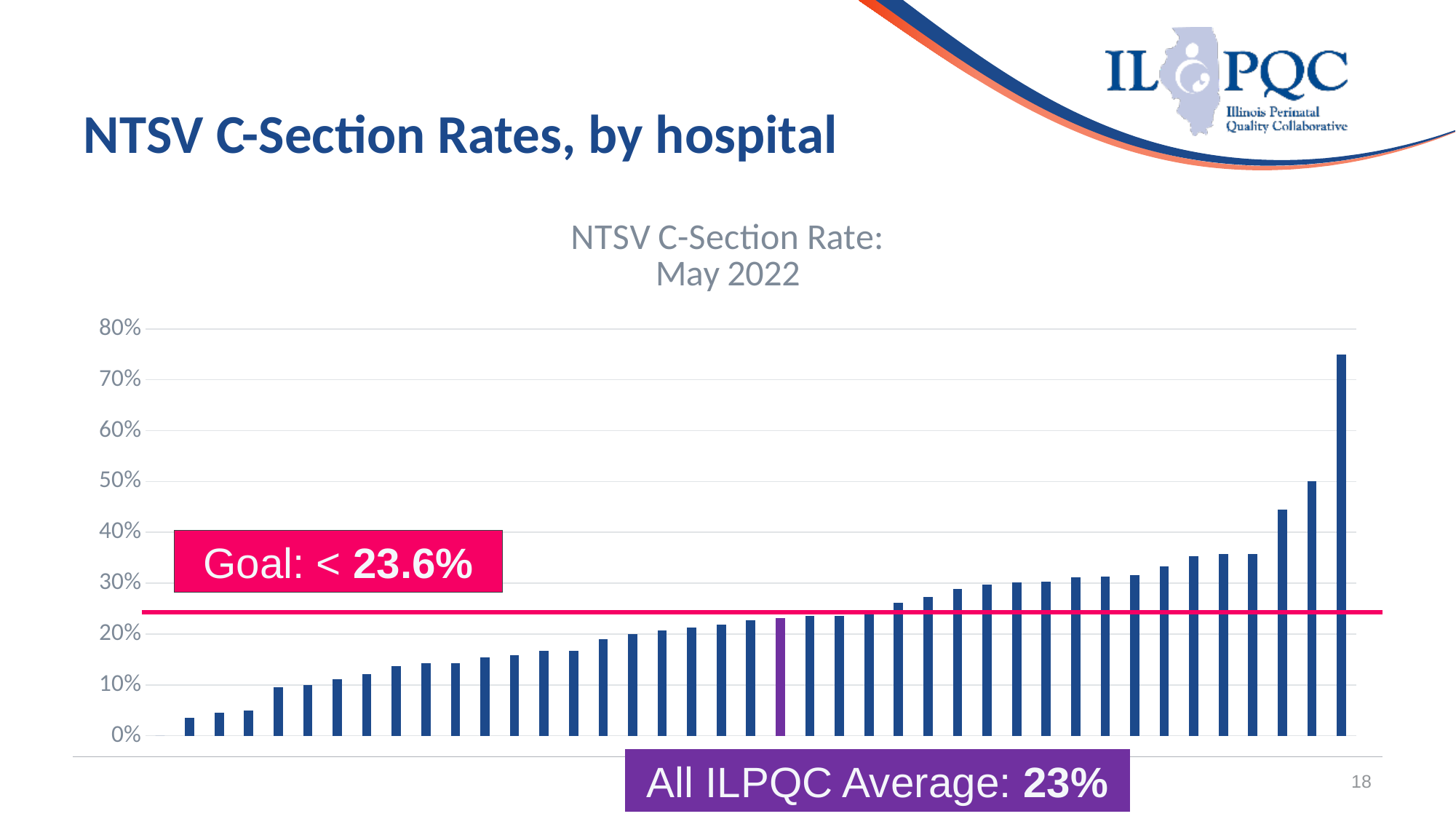
Which bar is the highest: the rightmost bar or the leftmost bar? the rightmost bar Is the value of the second bar from the right greater or less than 40%? greater What is the All ILPQC Average shown on the chart? 23% Is the value of the purple bar greater or less than 30%? less Is the horizontal goal line drawn above or below the 30% gridline? below Do the bar values rise or fall from left to right across the chart? rise What is the title of the chart? NTSV C-Section Rate: May 2022 What goal value is shown in the pink box on the chart? < 23.6% Which bar is highlighted in purple on the chart? the All ILPQC Average bar What kind of chart is shown on the slide? bar chart